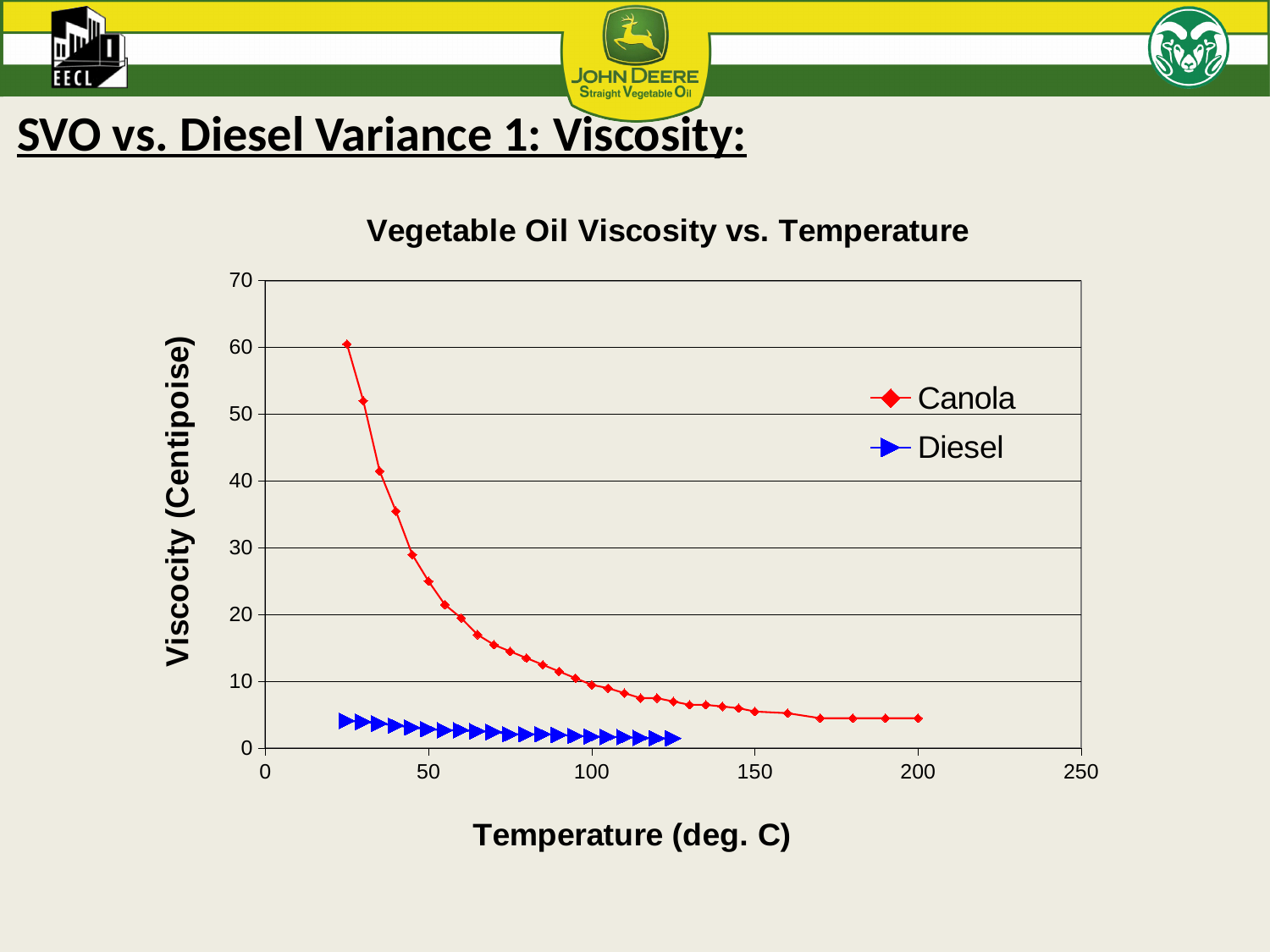
What is the title of the chart? Vegetable Oil Viscosity vs. Temperature Is the Canola viscosity at 200 deg. C greater or less than 10 centipoise? less Is the Canola viscosity at 100 deg. C greater or less than 20 centipoise? less What are the two series named in the legend? Canola and Diesel Is the Canola viscosity at 25 deg. C greater or less than 50 centipoise? greater What kind of chart is shown on the slide? line chart Does the Canola viscosity rise or fall as temperature increases along the x axis? fall At 100 deg. C, which series has the higher viscosity, Canola or Diesel? Canola How many series does the legend list? 2 Which series has the lower viscosity across the plotted temperature range? Diesel